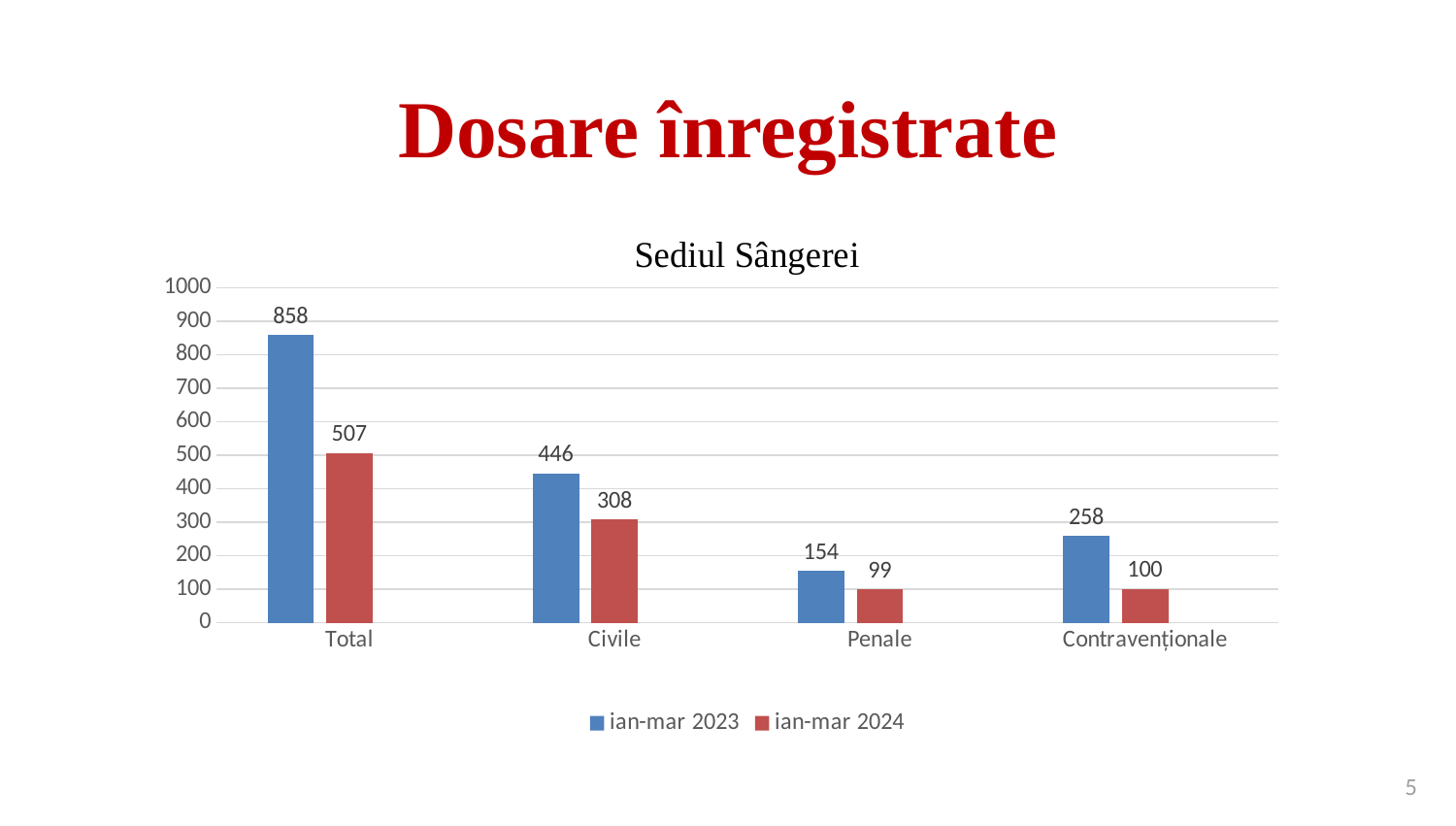
What is the title of the chart? Sediul Sângerei What is the value for Contravenționale in the ian-mar 2023 series? 258 What is the value for Civile in the ian-mar 2023 series? 446 Which is larger: the ian-mar 2024 value for Civile or the ian-mar 2023 value for Contravenționale? ian-mar 2024 value for Civile How many series does the legend list? 2 What is the difference between the ian-mar 2023 and ian-mar 2024 values for Total? 351 What is the value for Penale in the ian-mar 2024 series? 99 Which category has the lowest value in the ian-mar 2023 series? Penale What kind of chart is shown on the slide? bar chart Which category has the highest value in the ian-mar 2024 series? Total What is the difference between the ian-mar 2023 and ian-mar 2024 values for Civile? 138 How many categories are shown on the x axis? 4